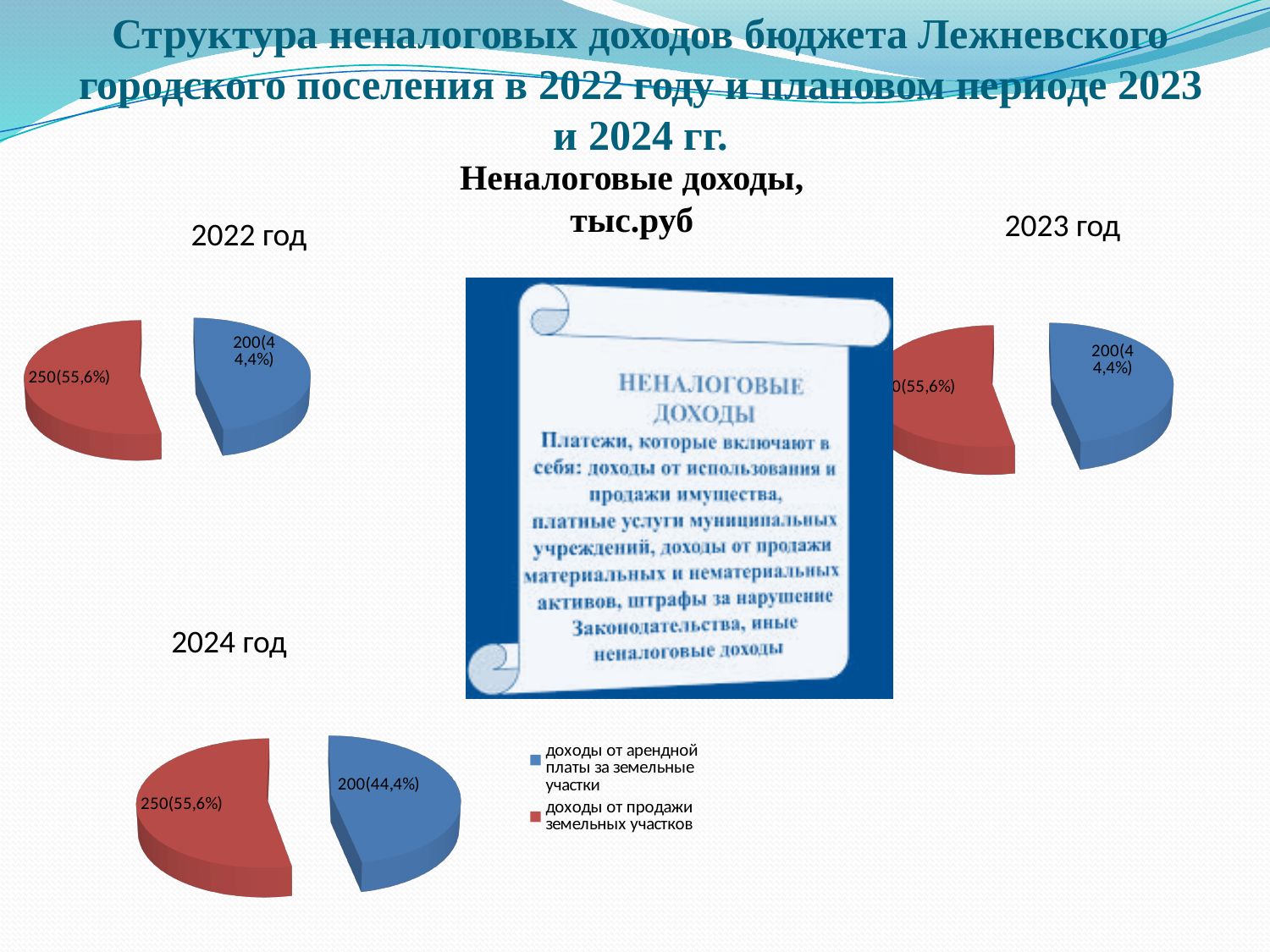
What kind of chart is the 2022 год chart? pie chart In the 2022 год chart, which category is the smallest? доходы от арендной платы за земельные участки In the 2024 год chart, which category is the largest? доходы от продажи земельных участков In the 2024 год chart, what share of the pie is доходы от арендной платы за земельные участки? 44,4% In the 2024 год chart, what is the value for доходы от продажи земельных участков? 250(55,6%) In the 2022 год chart, what is the value for доходы от арендной платы за земельные участки? 200(44,4%) How many slices does the 2024 год pie chart have? 2 Which colour represents доходы от продажи земельных участков in the legend? red In the 2023 год chart, what share of the pie is доходы от продажи земельных участков? 55,6% In the 2022 год chart, which is larger: доходы от арендной платы за земельные участки or доходы от продажи земельных участков? доходы от продажи земельных участков In the 2022 год chart, what is the value for доходы от продажи земельных участков? 250(55,6%) In the 2024 год chart, what is the difference between доходы от продажи земельных участков and доходы от арендной платы за земельные участки? 50